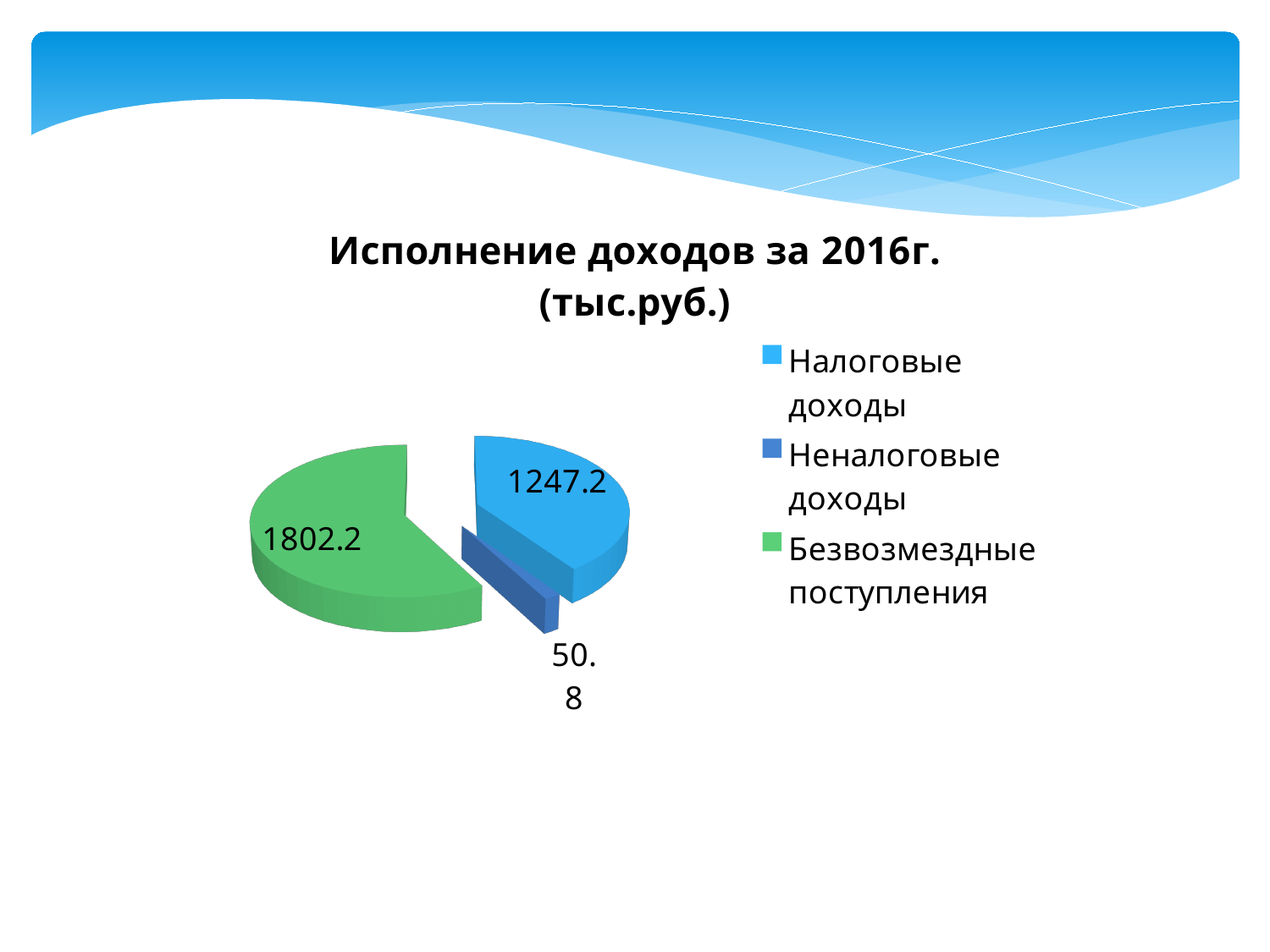
What type of chart is shown on the slide? Pie chart What is the total of all slices in the pie chart? 3100.2 What is the value for Налоговые доходы? 1247.2 Which is larger, Налоговые доходы or Безвозмездные поступления? Безвозмездные поступления How many slices does the pie chart have? 3 What is the title of the chart? Исполнение доходов за 2016г. (тыс.руб.) What is the difference between Безвозмездные поступления and Налоговые доходы? 555.0 What is the value for Безвозмездные поступления? 1802.2 Which category has the largest value? Безвозмездные поступления What is the value for Неналоговые доходы? 50.8 Which category has the smallest value? Неналоговые доходы What is the difference between Налоговые доходы and Неналоговые доходы? 1196.4